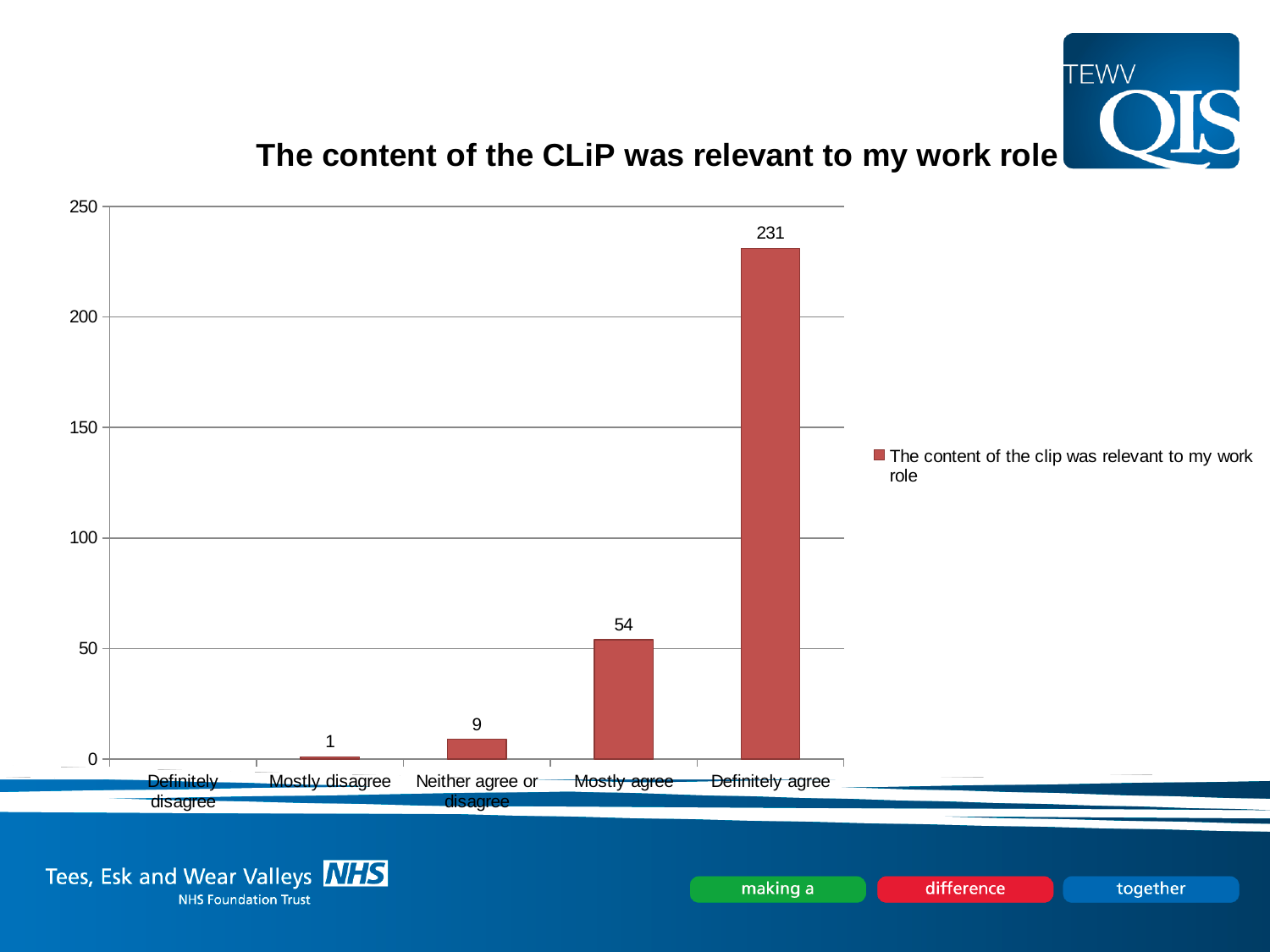
What is the value for Neither agree or disagree? 9 What is the title of the chart? The content of the CLiP was relevant to my work role What is the difference between the values for Definitely agree and Mostly agree? 177 What is the value for Mostly agree? 54 Which is larger, the value for Mostly agree or the value for Neither agree or disagree? Mostly agree Is the value for Definitely agree greater or less than 200? greater What is the value for Mostly disagree? 1 How many categories are shown on the x axis? 5 Which category has the highest value? Definitely agree What kind of chart is shown on the slide? Bar chart What is the value for Definitely agree? 231 What is the difference between the values for Mostly agree and Neither agree or disagree? 45